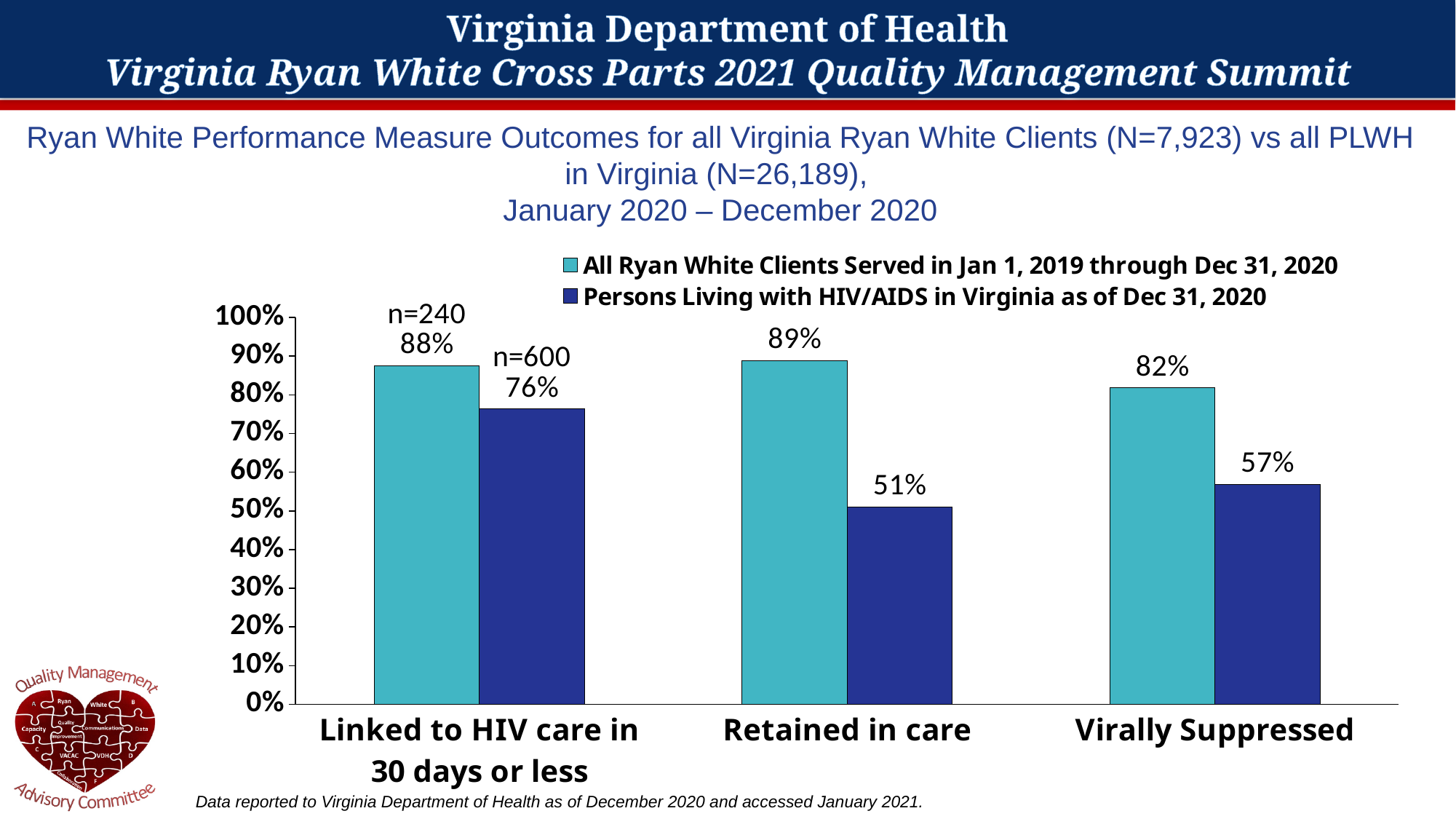
How many series does the legend list? 2 How many categories are shown on the x axis? 3 Which category has the highest value for All Ryan White Clients? Retained in care What is the value for Persons Living with HIV/AIDS in Virginia for Virally Suppressed? 57% What is the difference between the All Ryan White Clients value and the Persons Living with HIV/AIDS value for Virally Suppressed? 25% What kind of chart is shown on the slide? Bar chart Which is larger for Linked to HIV care in 30 days or less: All Ryan White Clients or Persons Living with HIV/AIDS in Virginia? All Ryan White Clients What is the difference between the All Ryan White Clients value and the Persons Living with HIV/AIDS value for Retained in care? 38% What is the value for All Ryan White Clients for Retained in care? 89% What is the n value shown above the Persons Living with HIV/AIDS bar for Linked to HIV care in 30 days or less? n=600 Which category has the lowest value for Persons Living with HIV/AIDS in Virginia? Retained in care What is the value for Persons Living with HIV/AIDS in Virginia for Linked to HIV care in 30 days or less? 76%